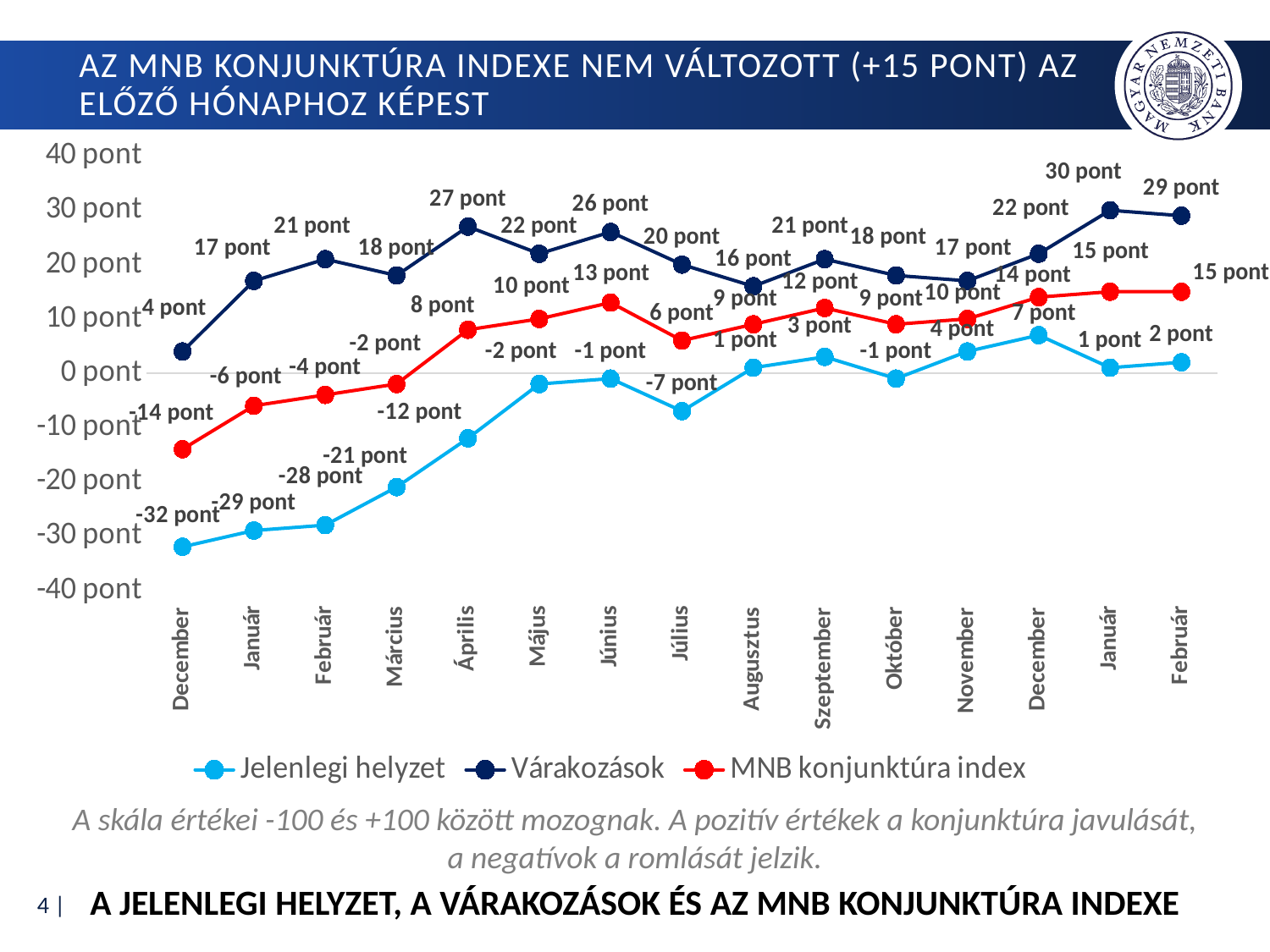
In which month does Várakozások reach its highest value? Január (the second one) In which month is Jelenlegi helyzet at its lowest? December (the first one) How many series does the legend list? 3 What kind of chart is shown on the slide? line chart What is the value of the MNB konjunktúra index in the last Február on the x axis? 15 pont How many months are plotted along the x axis? 15 Which is larger for the MNB konjunktúra index: the value in Május or in Szeptember? Szeptember What is the value of Várakozások in Április? 27 pont What colour is the MNB konjunktúra index line? red What is the difference between Várakozások and Jelenlegi helyzet in Június? 27 pont What is the value of Jelenlegi helyzet in Július? -7 pont Does Jelenlegi helyzet rise or fall from the first December to Május? rise